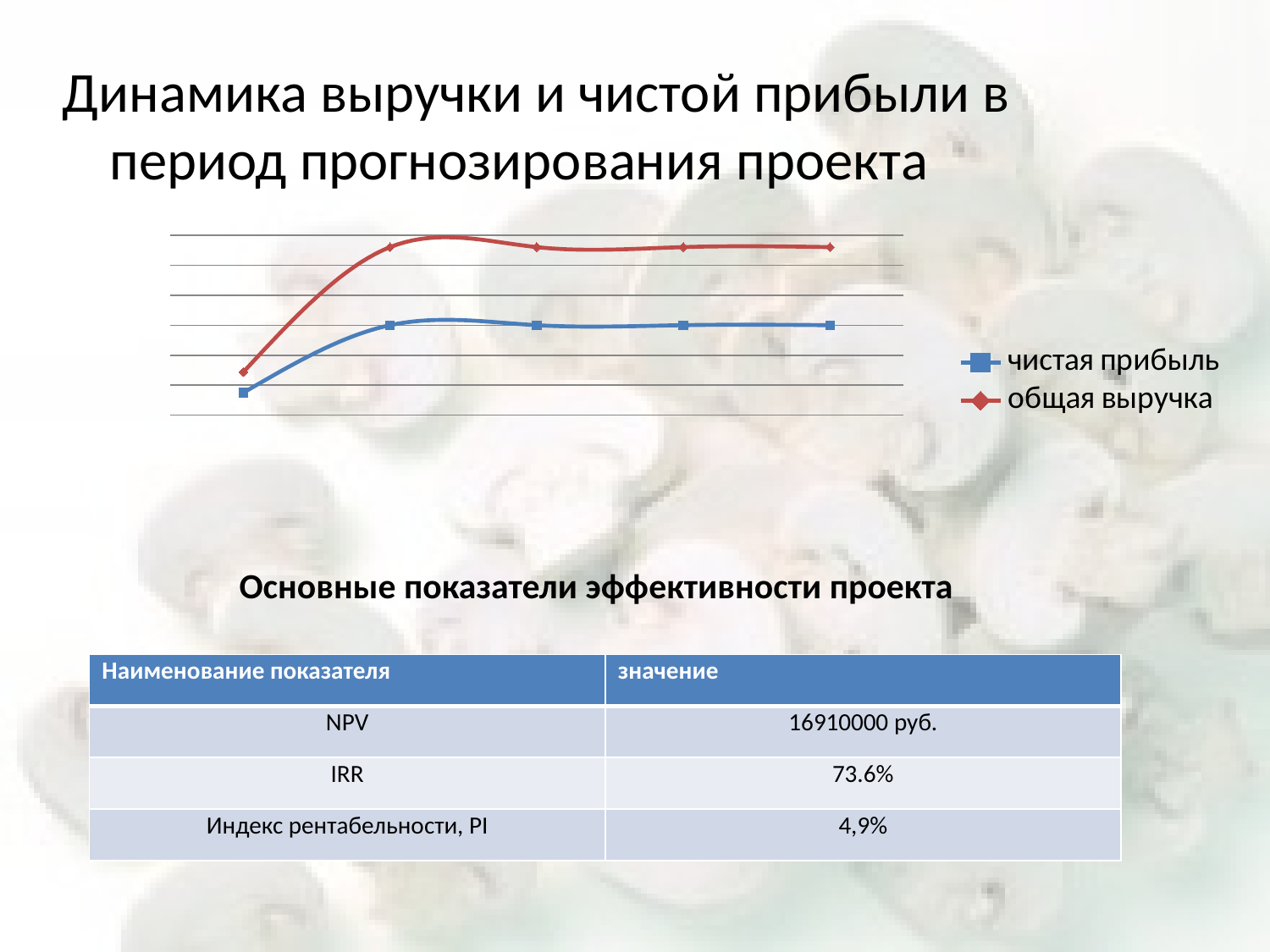
Do the values of чистая прибыль rise or fall between the first and second points? rise How many data points does each line in the chart have? 5 How many series does the chart's legend list? 2 Which series has the highest values on the chart? общая выручка What colour is the line for общая выручка? red What colour is the line for чистая прибыль? blue Do the values of общая выручка rise or fall between the first and second points? rise Which series is plotted higher on the chart, чистая прибыль or общая выручка? общая выручка At which point is общая выручка at its lowest, the first or the last? the first Which series has the lowest values on the chart? чистая прибыль What kind of chart is shown on the slide? line chart